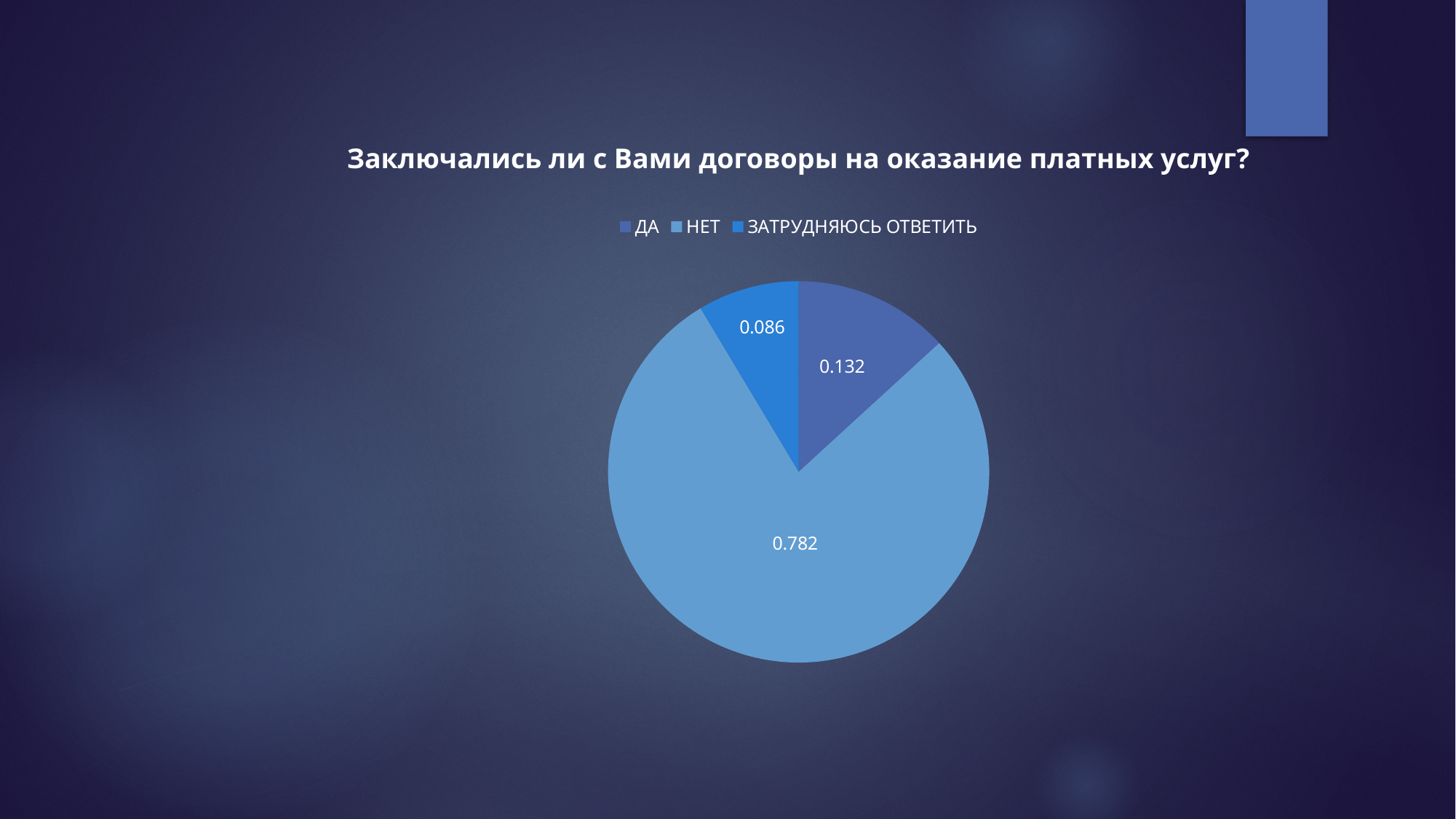
What is the value for НЕТ? 0.782 What is the title of the chart? Заключались ли с Вами договоры на оказание платных услуг? What type of chart is shown on the slide? pie chart What is the value for ДА? 0.132 Which category has the largest slice of the pie? НЕТ What is the difference between the values for ДА and ЗАТРУДНЯЮСЬ ОТВЕТИТЬ? 0.046 How many slices does the pie chart have? 3 Which category has the smallest slice of the pie? ЗАТРУДНЯЮСЬ ОТВЕТИТЬ What is the value for ЗАТРУДНЯЮСЬ ОТВЕТИТЬ? 0.086 How many entries does the legend list? 3 Which is larger, the value for ДА or the value for ЗАТРУДНЯЮСЬ ОТВЕТИТЬ? ДА What is the difference between the values for НЕТ and ДА? 0.65